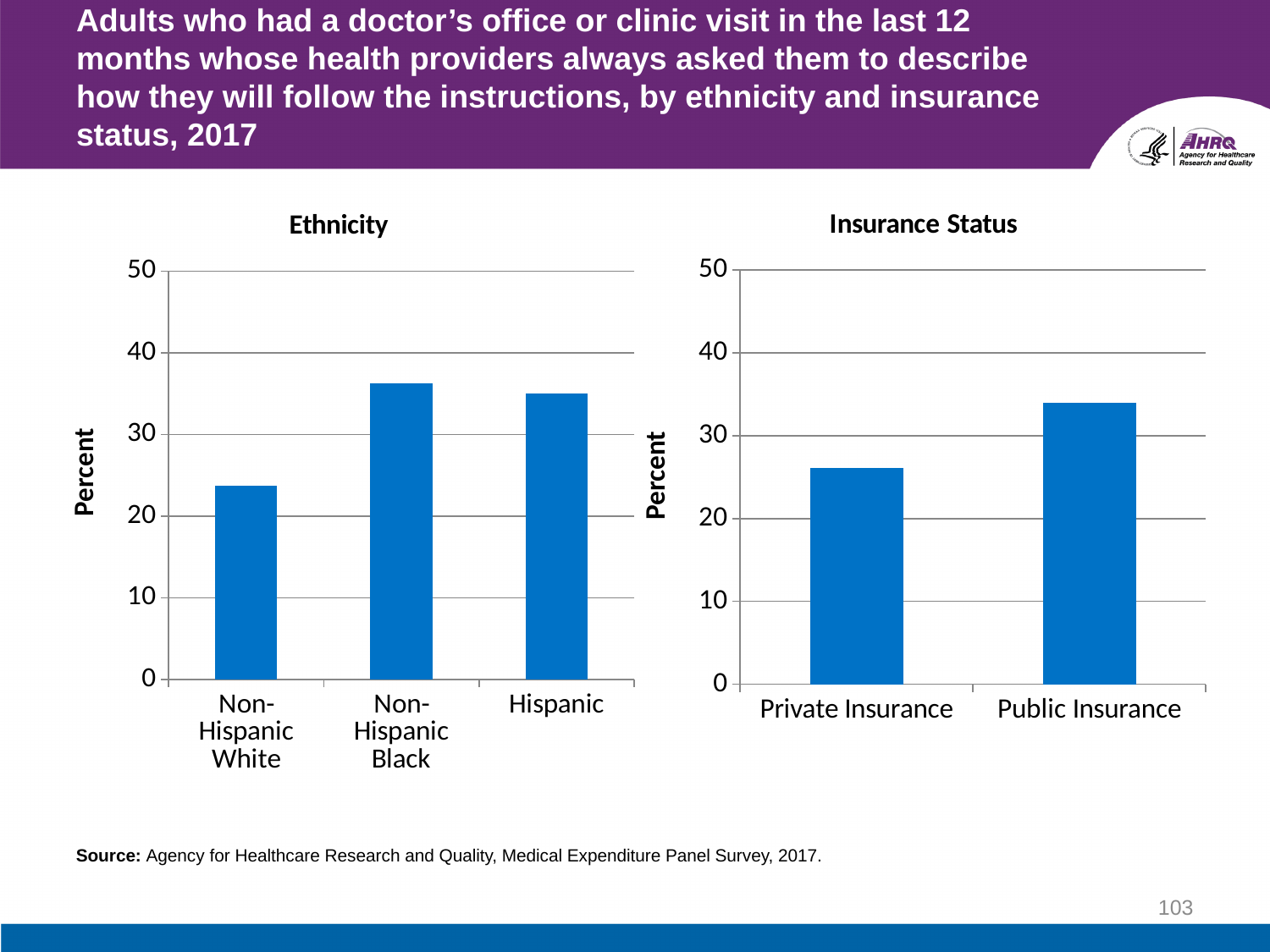
In the Ethnicity chart, which category has the lowest value? Non-Hispanic White What is the label on the vertical axis of the Ethnicity chart? Percent In the Ethnicity chart, is the value for Non-Hispanic White greater or less than 30? less In the Insurance Status chart, which category has the highest value? Public Insurance In the Ethnicity chart, is the value for Hispanic greater or less than 40? less In the Ethnicity chart, is the value for Non-Hispanic Black greater or less than 30? greater In the Ethnicity chart, which is larger, the value for Non-Hispanic White or the value for Hispanic? Hispanic What kind of chart is the Insurance Status chart? bar chart How many categories are shown in the Ethnicity chart? 3 How many categories are shown in the Insurance Status chart? 2